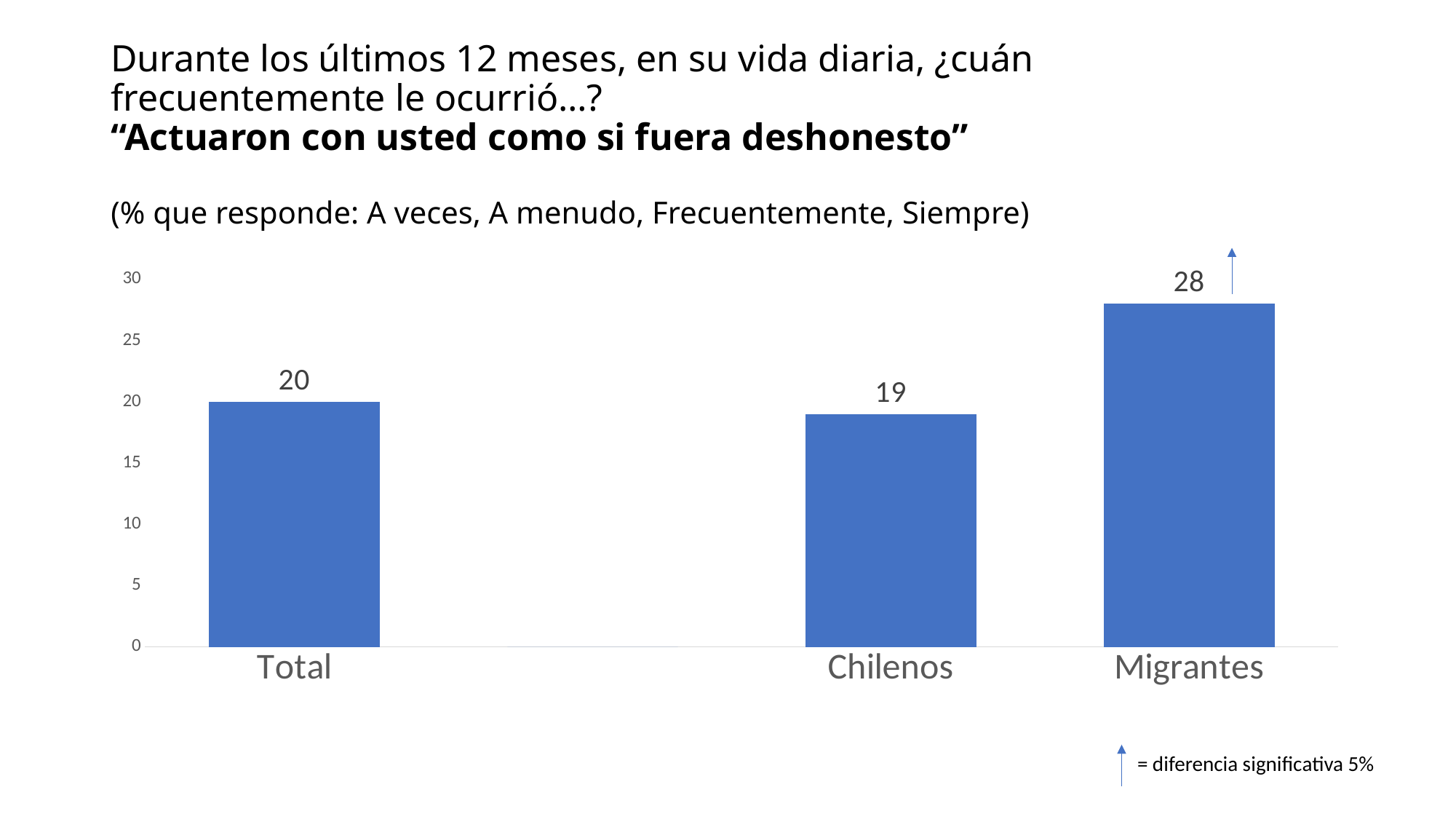
How many categories are shown on the x axis? 3 What is the difference between the values for Migrantes and Chilenos? 9 What kind of chart is shown on the slide? bar chart Which is larger, the value for Migrantes or the value for Total? Migrantes According to the legend note, what does the blue arrow indicate? diferencia significativa 5% Is the value for Migrantes greater or less than 25? greater Which category has the lowest value? Chilenos Which category has the highest value? Migrantes What is the value for Total? 20 What is the difference between the values for Migrantes and Total? 8 What is the value for Chilenos? 19 What is the value for Migrantes? 28